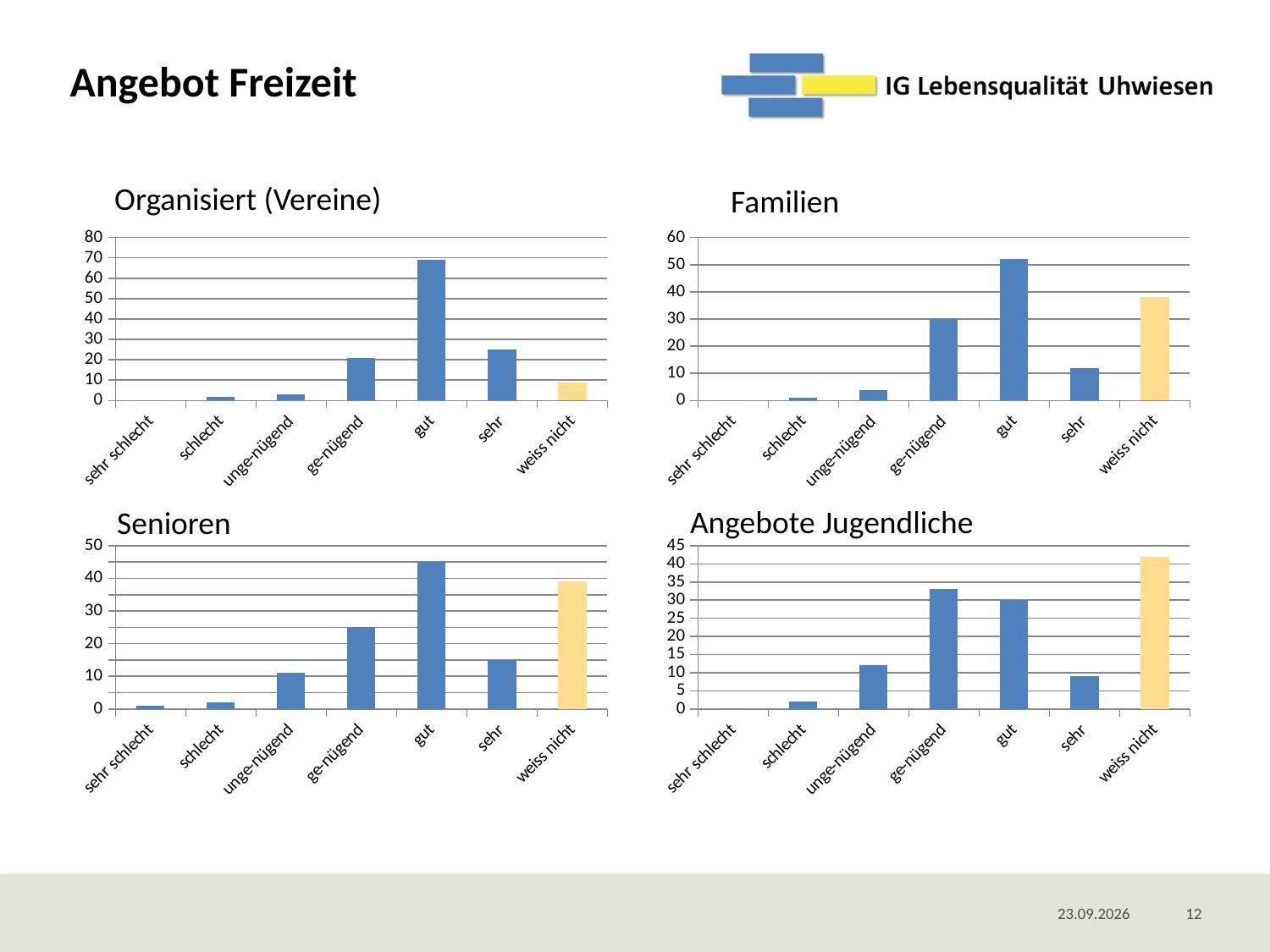
In the 'Organisiert (Vereine)' chart, is the value for 'gut' greater or less than 60? greater In the 'Familien' chart, which is larger, the value for 'gut' or the value for 'weiss nicht'? gut How many charts are shown on the slide? 4 How many categories are shown on the x axis of the 'Organisiert (Vereine)' chart? 7 What kind of chart is the 'Senioren' chart? bar chart In the 'Angebote Jugendliche' chart, which is larger, the value for 'ge-nügend' or the value for 'sehr'? ge-nügend In the 'Angebote Jugendliche' chart, which category has the highest bar? weiss nicht In the 'Familien' chart, is the value for 'weiss nicht' greater or less than 30? greater In the 'Senioren' chart, is the value for 'ge-nügend' greater or less than 20? greater In the 'Organisiert (Vereine)' chart, which category has the highest bar? gut In the 'Senioren' chart, which category has the highest bar? gut